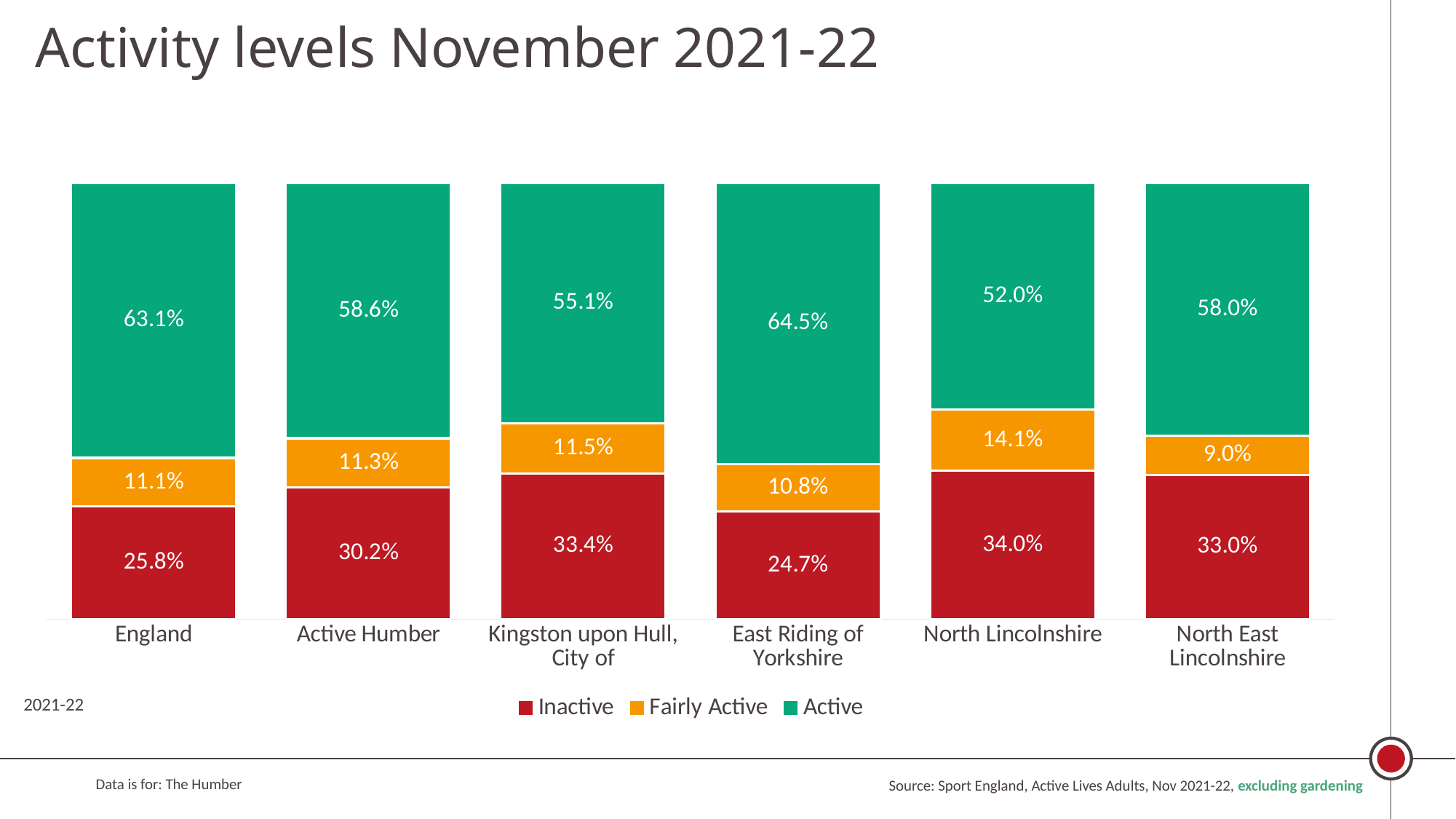
What is the Fairly Active percentage for North East Lincolnshire? 9.0% How many areas are shown on the x axis? 6 What is the title of the chart? 2021-22 Which area has the highest Inactive percentage? North Lincolnshire Which has a larger Fairly Active percentage, North Lincolnshire or Active Humber? North Lincolnshire What is the Active percentage for East Riding of Yorkshire? 64.5% How many series does the legend list? 3 What is the Inactive percentage for Active Humber? 30.2% Which area has the lowest Active percentage? North Lincolnshire What is the difference between the Active percentage for England and for Kingston upon Hull, City of? 8.0% Which colour represents the Inactive series? Red What kind of chart is shown? Stacked bar chart